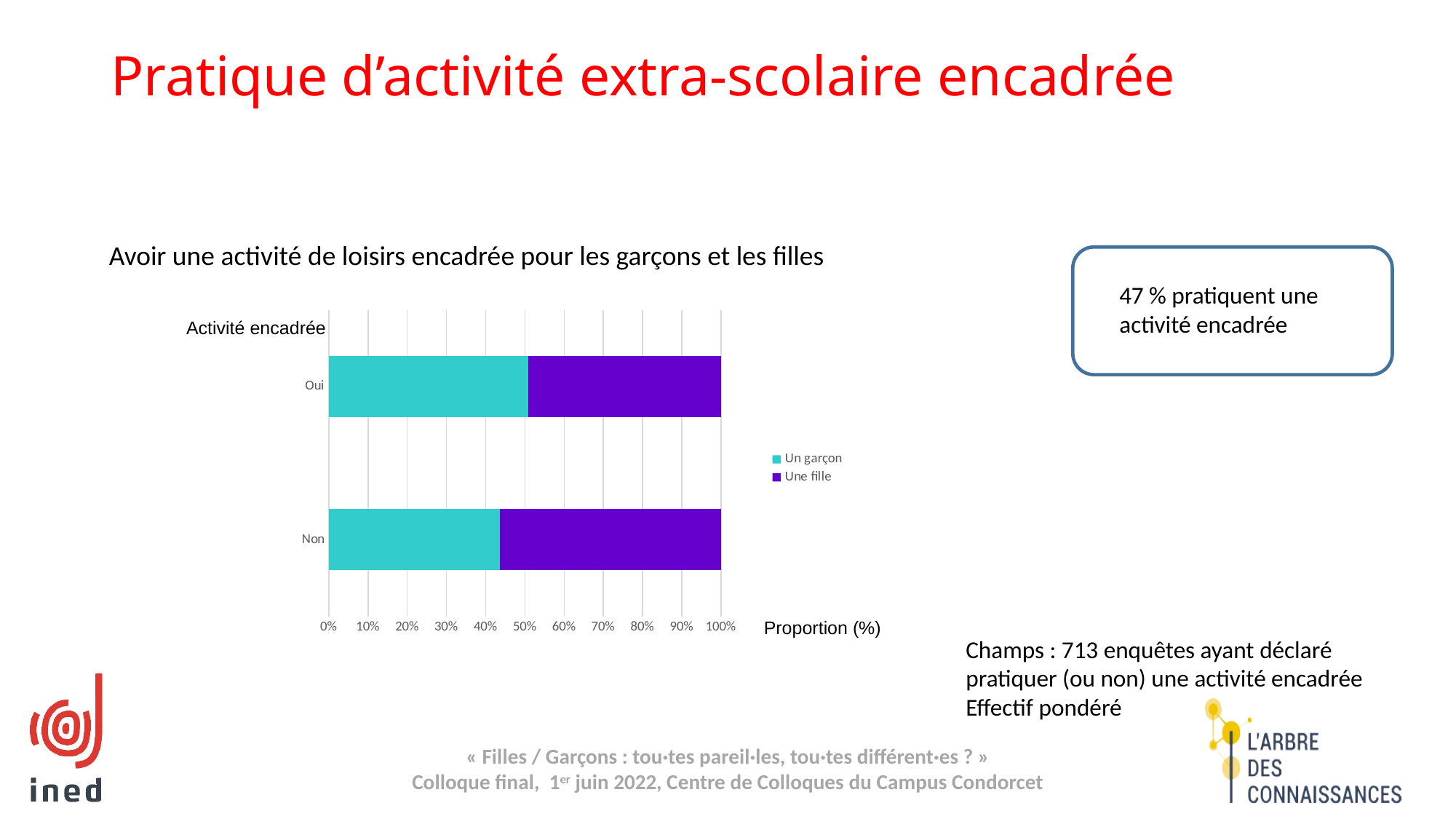
In the 'Non' bar, which series has the larger share, 'Un garçon' or 'Une fille'? Une fille Which series are listed in the chart legend? Un garçon, Une fille Is the 'Un garçon' share larger in the 'Oui' bar or in the 'Non' bar? Oui Is the 'Une fille' share of the 'Non' bar greater or less than 50%? greater How many categories are plotted on the vertical axis of the chart? 2 What is the label of the horizontal axis of the chart? Proportion (%) What is the total of the 'Oui' stacked bar? 100% What kind of chart is shown on the slide? Stacked bar chart Is the 'Un garçon' share of the 'Oui' bar greater or less than 40%? greater What is the title of the chart? Avoir une activité de loisirs encadrée pour les garçons et les filles Is the 'Un garçon' share of the 'Non' bar greater or less than 50%? less How many series does the chart legend list? 2